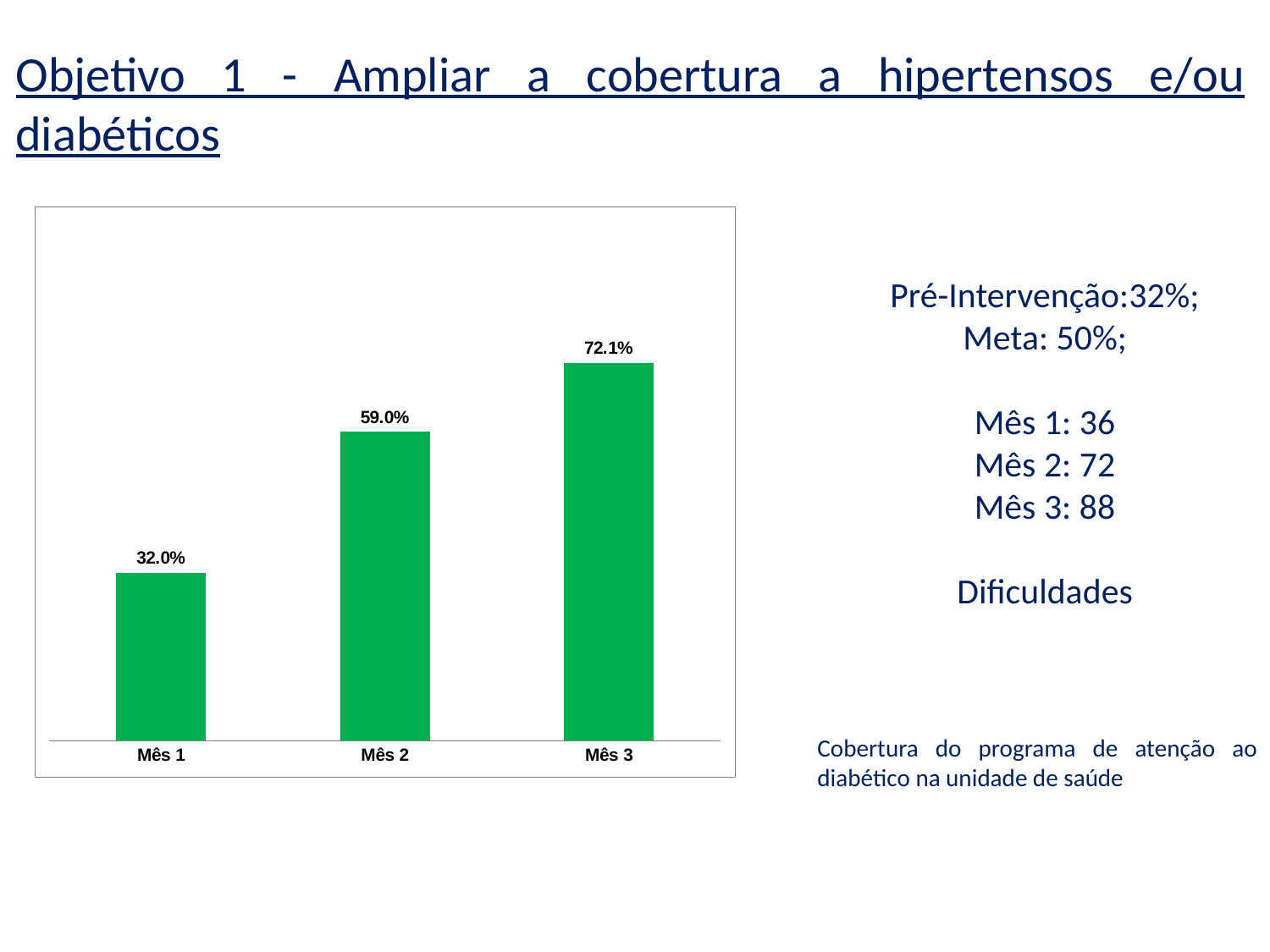
What is the value for Mês 2? 59.0% Which month has the highest value? Mês 3 Which is larger, the value for Mês 2 or the value for Mês 3? Mês 3 What colour are the bars in the chart? Green Which month has the lowest value? Mês 1 What is the difference between the values for Mês 3 and Mês 1? 40.1% How many bars are shown in the chart? 3 Do the values rise or fall from Mês 1 to Mês 3? Rise What is the difference between the values for Mês 2 and Mês 1? 27.0% What is the value for Mês 3? 72.1% What kind of chart is shown on the slide? Bar chart What is the value for Mês 1? 32.0%